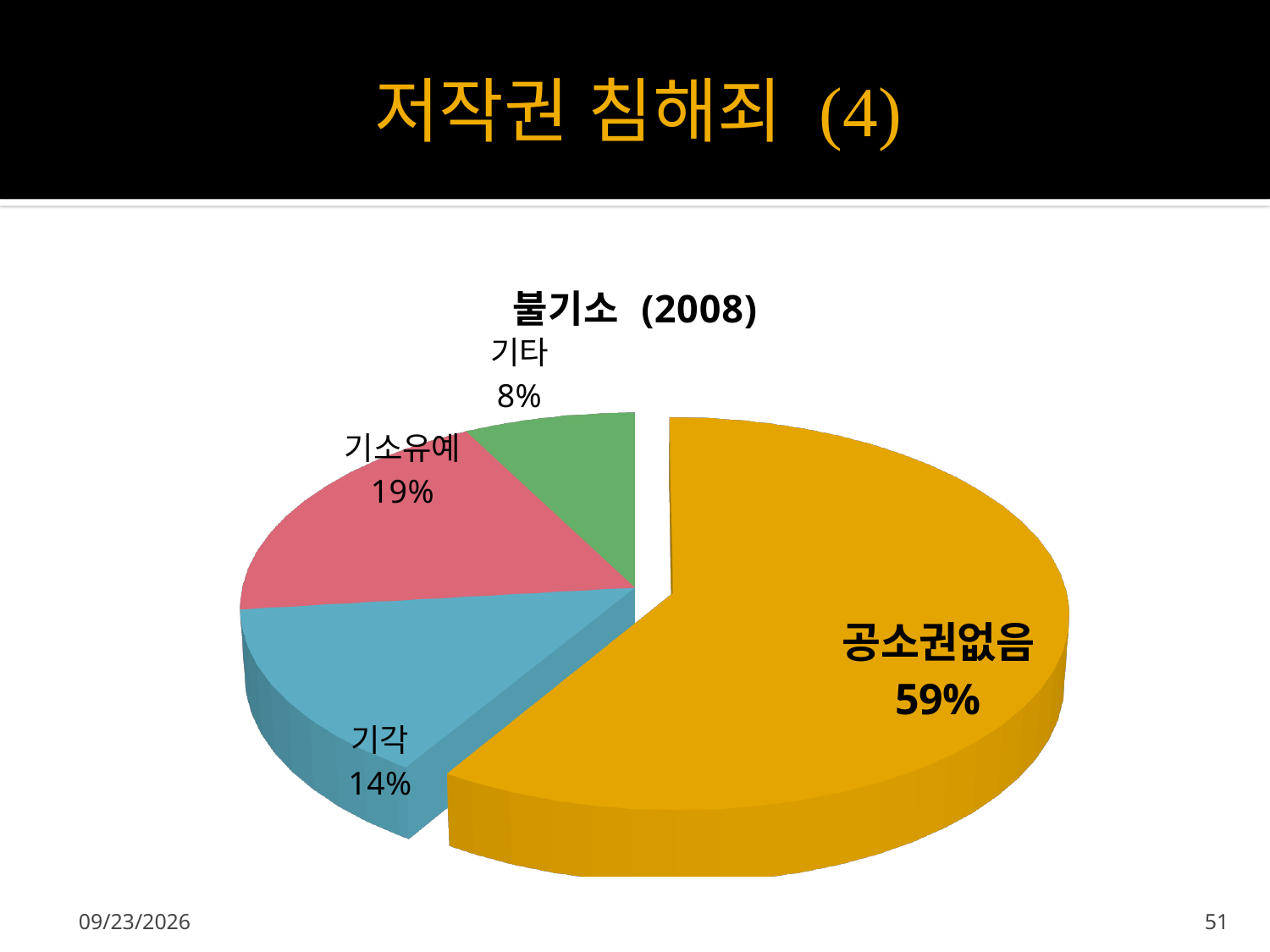
What share of the pie does 기각 represent? 14% What share of the pie does 기소유예 represent? 19% How many slices does the pie chart have? 4 What is the difference in percentage points between 기소유예 and 기각? 5% Which is larger, the share for 기소유예 or the share for 기타? 기소유예 Which category has the smallest slice of the pie? 기타 What is the title of the chart? 불기소 (2008) What share of the pie does 기타 represent? 8% Which category has the largest slice of the pie? 공소권없음 What colour is the slice for 공소권없음? Yellow/orange What type of chart is shown on the slide? Pie chart